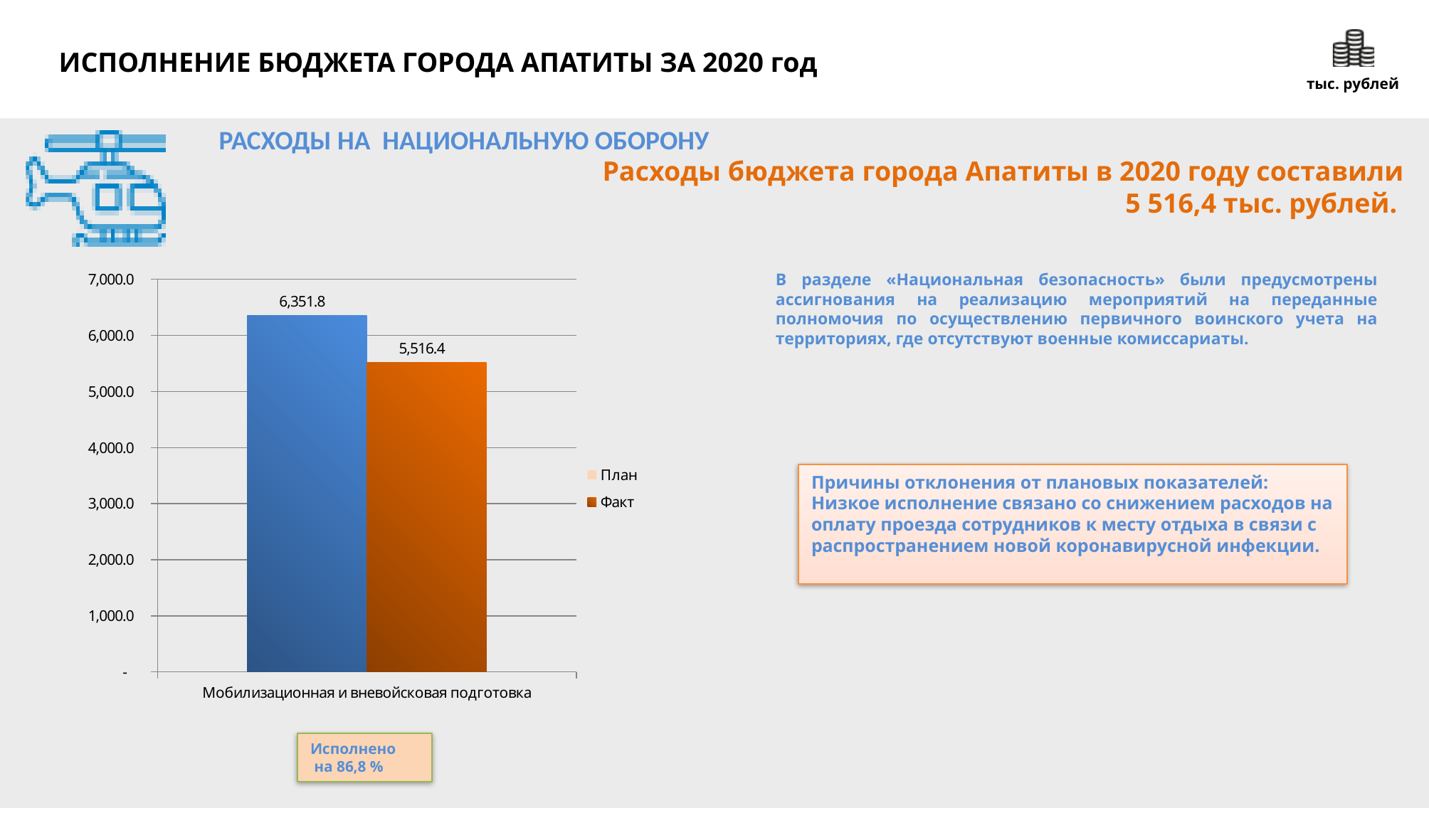
How many series does the legend list? 2 What is the difference between the План and Факт values? 835.4 Which series has the higher value, План or Факт? План What is the maximum value shown on the y axis? 7,000.0 What kind of chart is shown on the slide? bar chart Is the Факт value greater or less than 6,000.0? less What is the name of the category on the x axis? Мобилизационная и вневойсковая подготовка Is the План value greater or less than 6,000.0? greater What is the value of the План (plan) bar for Мобилизационная и вневойсковая подготовка? 6,351.8 What is the value of the Факт (actual) bar for Мобилизационная и вневойсковая подготовка? 5,516.4 How many categories are shown on the x axis? 1